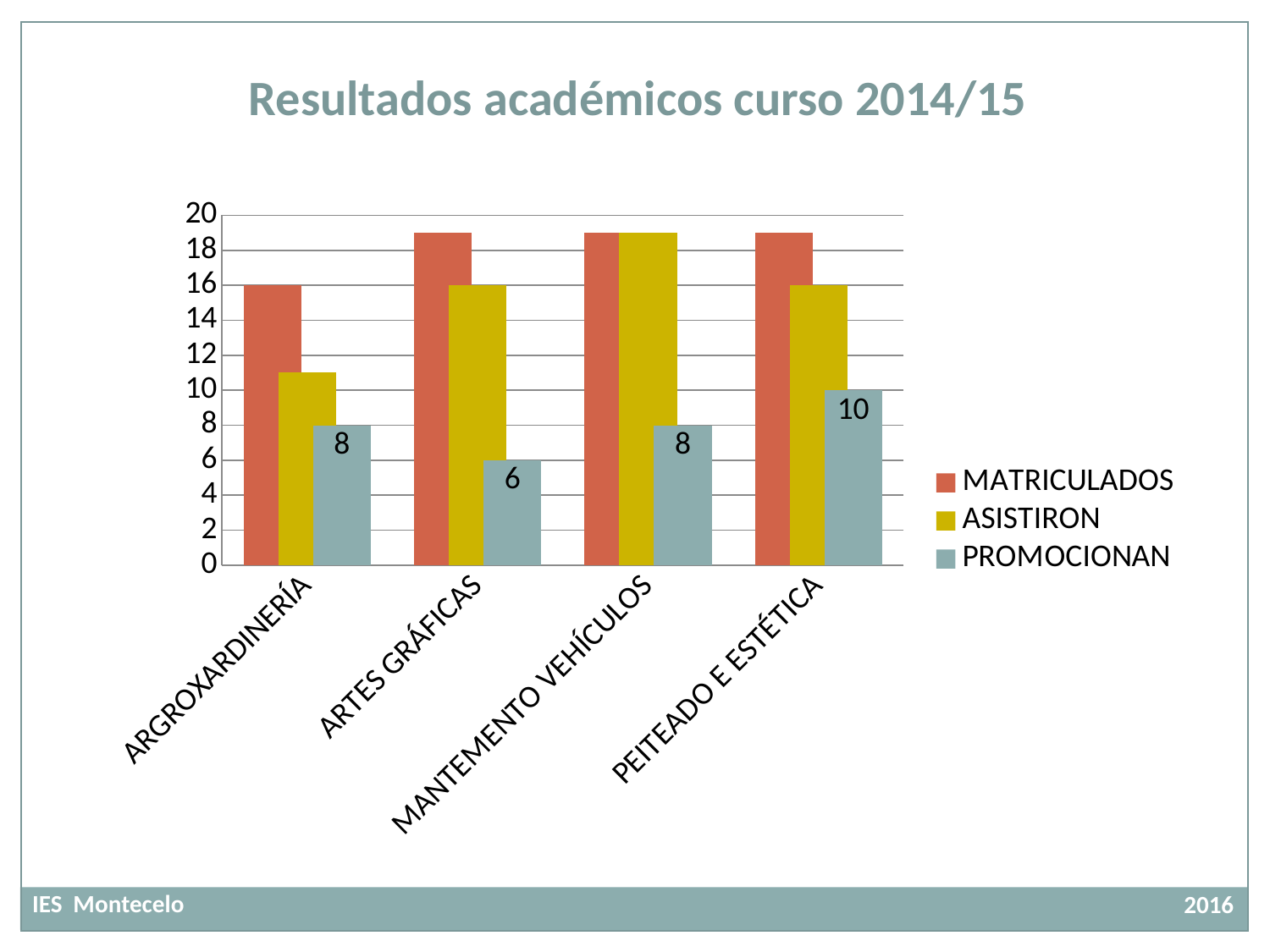
What is the MATRICULADOS value for ARGROXARDINERÍA? 16 Is the MATRICULADOS value for ARTES GRÁFICAS greater or less than 18? greater What kind of chart is shown on the slide? bar chart What is the ASISTIRON value for ARTES GRÁFICAS? 16 How many categories are shown on the x axis? 4 Which category has the lowest PROMOCIONAN value? ARTES GRÁFICAS What is the PROMOCIONAN value for ARTES GRÁFICAS? 6 What is the PROMOCIONAN value for PEITEADO E ESTÉTICA? 10 Which category has the highest PROMOCIONAN value? PEITEADO E ESTÉTICA How many series does the legend list? 3 What is the difference between the PROMOCIONAN values for PEITEADO E ESTÉTICA and ARTES GRÁFICAS? 4 For MANTEMENTO VEHÍCULOS, which is larger: ASISTIRON or PROMOCIONAN? ASISTIRON